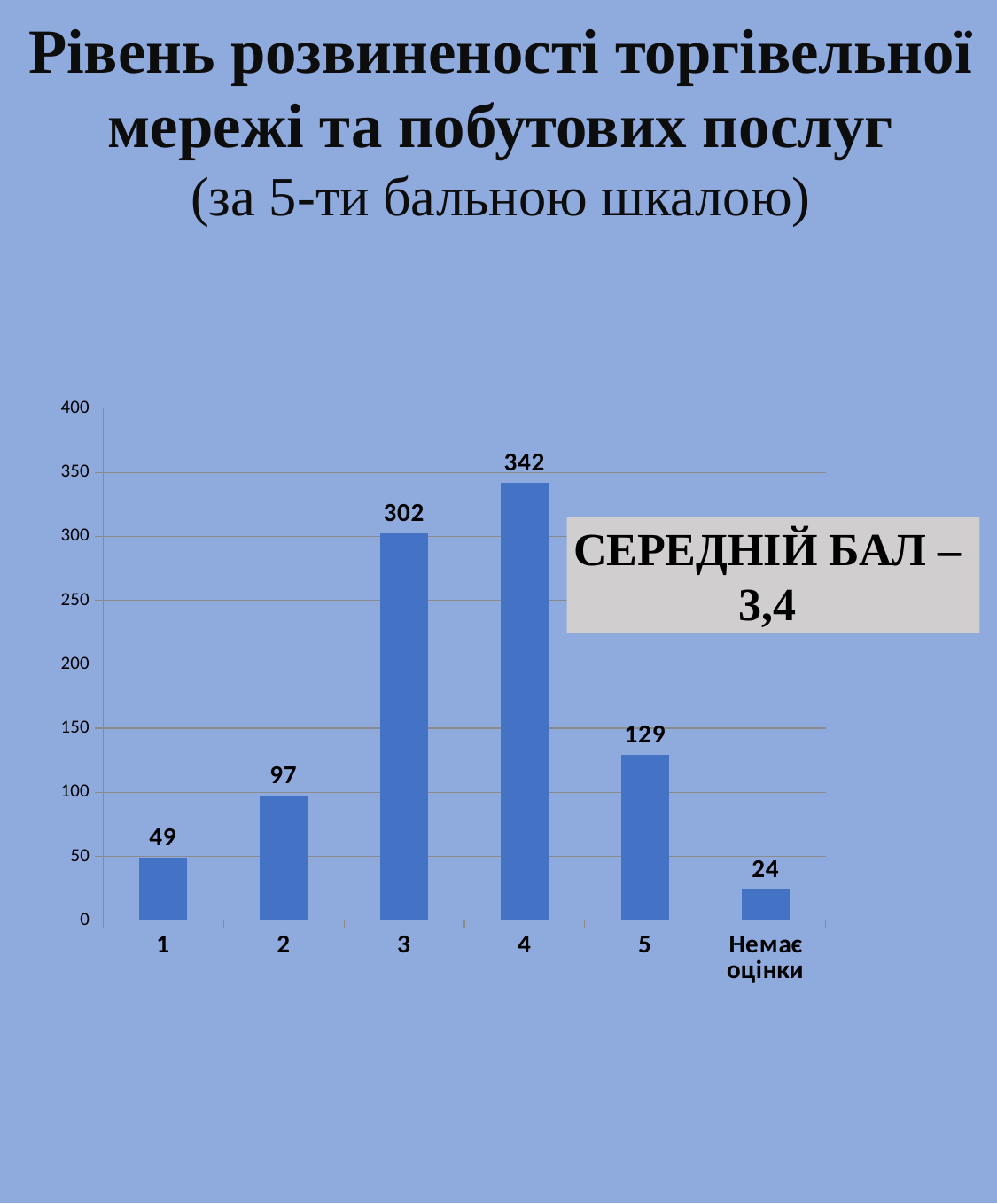
How many categories are shown on the x axis? 6 What is the value for category 3? 302 What is the difference between the values for categories 4 and 3? 40 Which is larger, the value for category 2 or the value for category 5? 5 What average score (середній бал) is stated in the box on the chart? 3,4 What is the value for the "Немає оцінки" category? 24 Which category has the highest value? 4 Which category has the lowest value? Немає оцінки Is the value for category 3 greater or less than 250? greater What kind of chart is shown on the slide? bar chart What is the value for category 5? 129 What is the difference between the values for categories 2 and 1? 48